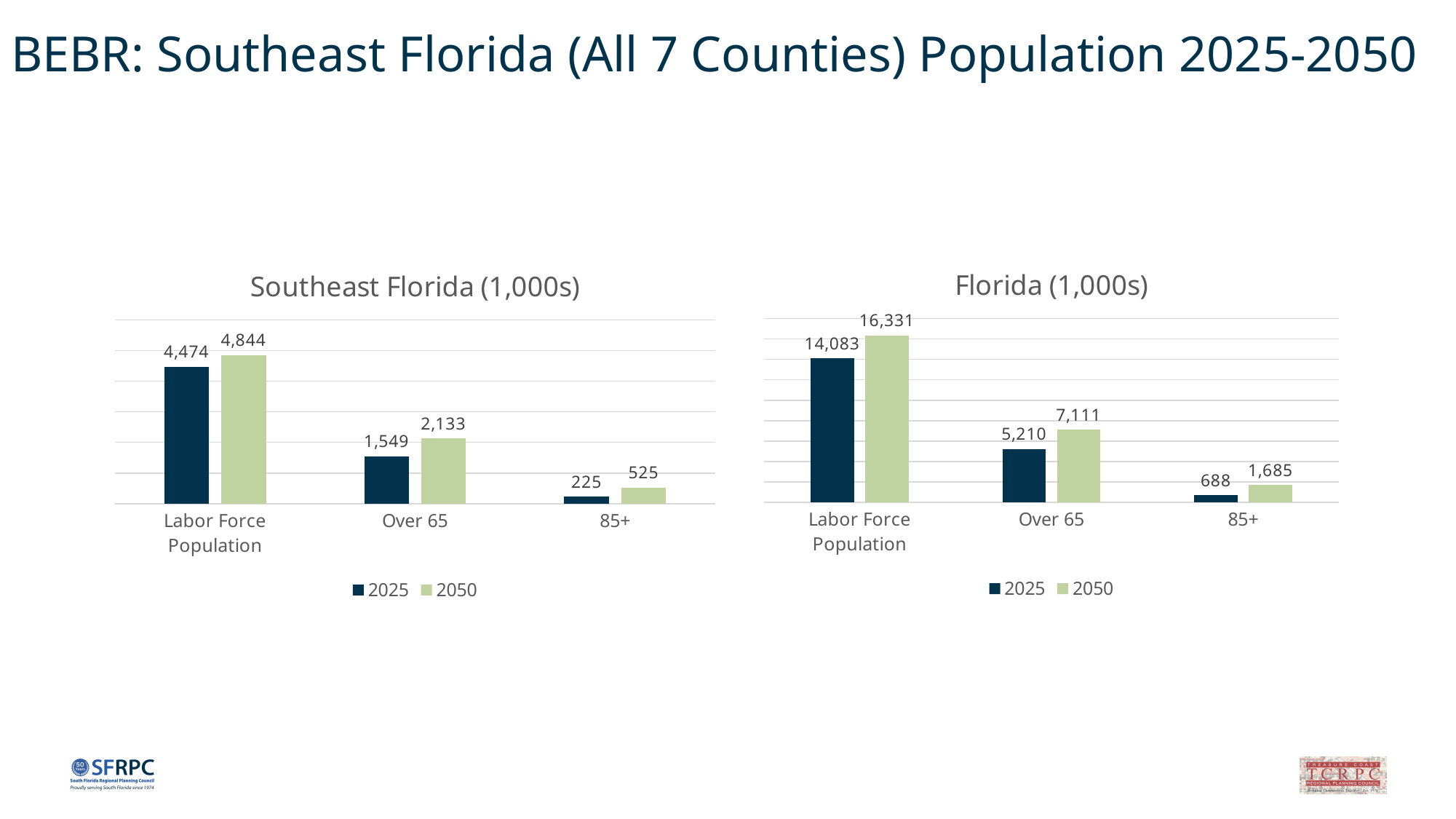
In the Florida (1,000s) chart, what is the difference between the 2050 and 2025 values for Over 65? 1,901 In the Florida (1,000s) chart, what is the 2050 value for Labor Force Population? 16,331 How many series does the legend of the Southeast Florida (1,000s) chart list? 2 In the Florida (1,000s) chart, which category has the highest 2050 value? Labor Force Population In the Southeast Florida (1,000s) chart, which is larger for Over 65: the 2025 value or the 2050 value? 2050 What kind of chart is the Florida (1,000s) chart? Bar chart In the Southeast Florida (1,000s) chart, which category has the lowest 2025 value? 85+ In the Southeast Florida (1,000s) chart, what is the 2050 value for Over 65? 2,133 In the Florida (1,000s) chart, what is the 2025 value for 85+? 688 How many categories are shown on the x axis of the Florida (1,000s) chart? 3 In the Southeast Florida (1,000s) chart, what is the difference between the 2050 and 2025 values for 85+? 300 In the Southeast Florida (1,000s) chart, what is the 2025 value for Labor Force Population? 4,474